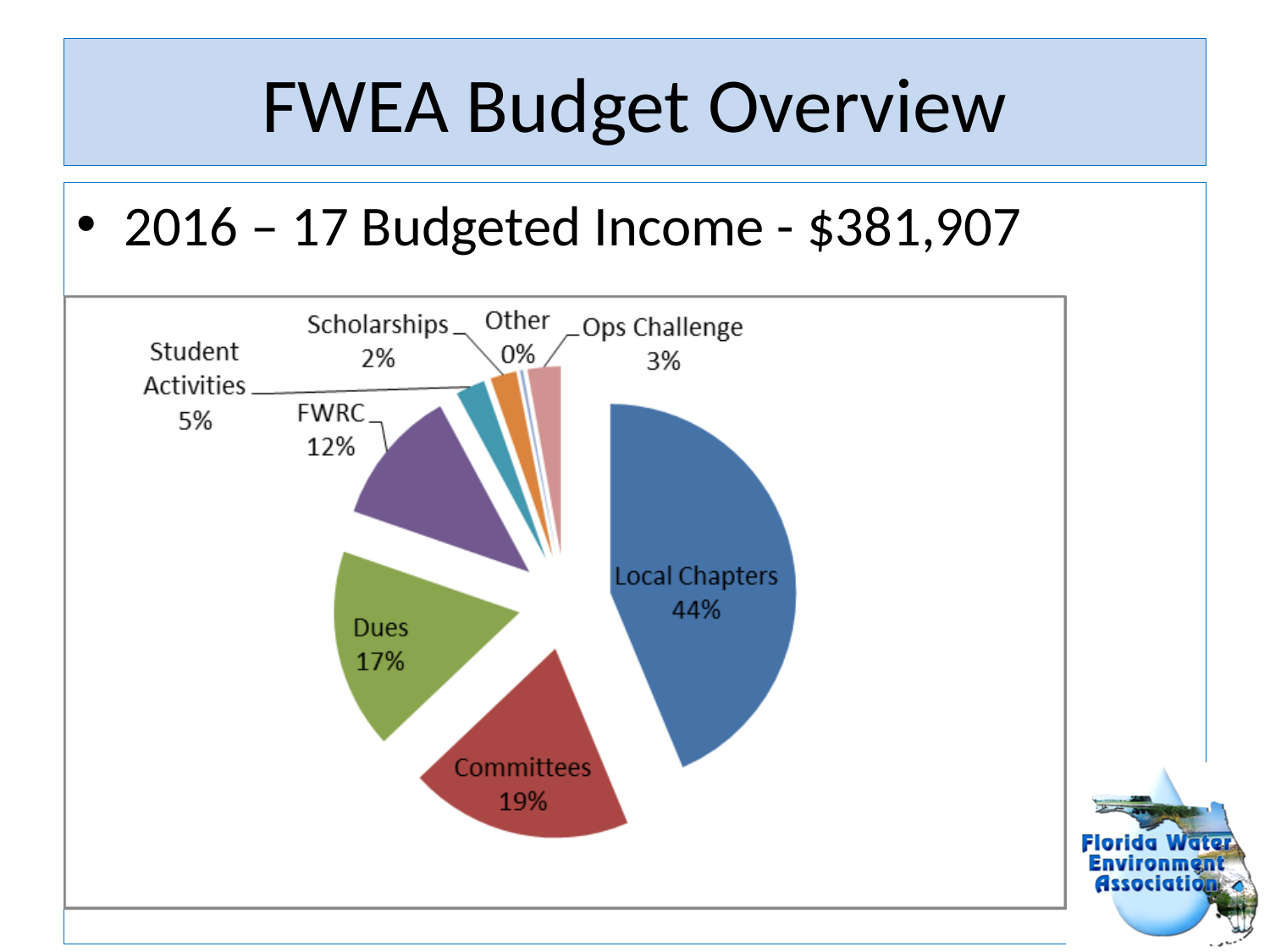
What share of the budgeted income comes from Local Chapters? 44% What share of the budgeted income comes from Dues? 17% What share of the budgeted income comes from Committees? 19% Which is larger, the share for FWRC or the share for Ops Challenge? FWRC Which category has the largest share of the pie? Local Chapters What is the difference in percentage points between Committees and Dues? 2% What kind of chart is shown on the slide? pie chart What total budgeted income for 2016–17 is stated on the slide? $381,907 Which category has the smallest share of the pie? Other How many categories are shown in the pie chart? 8